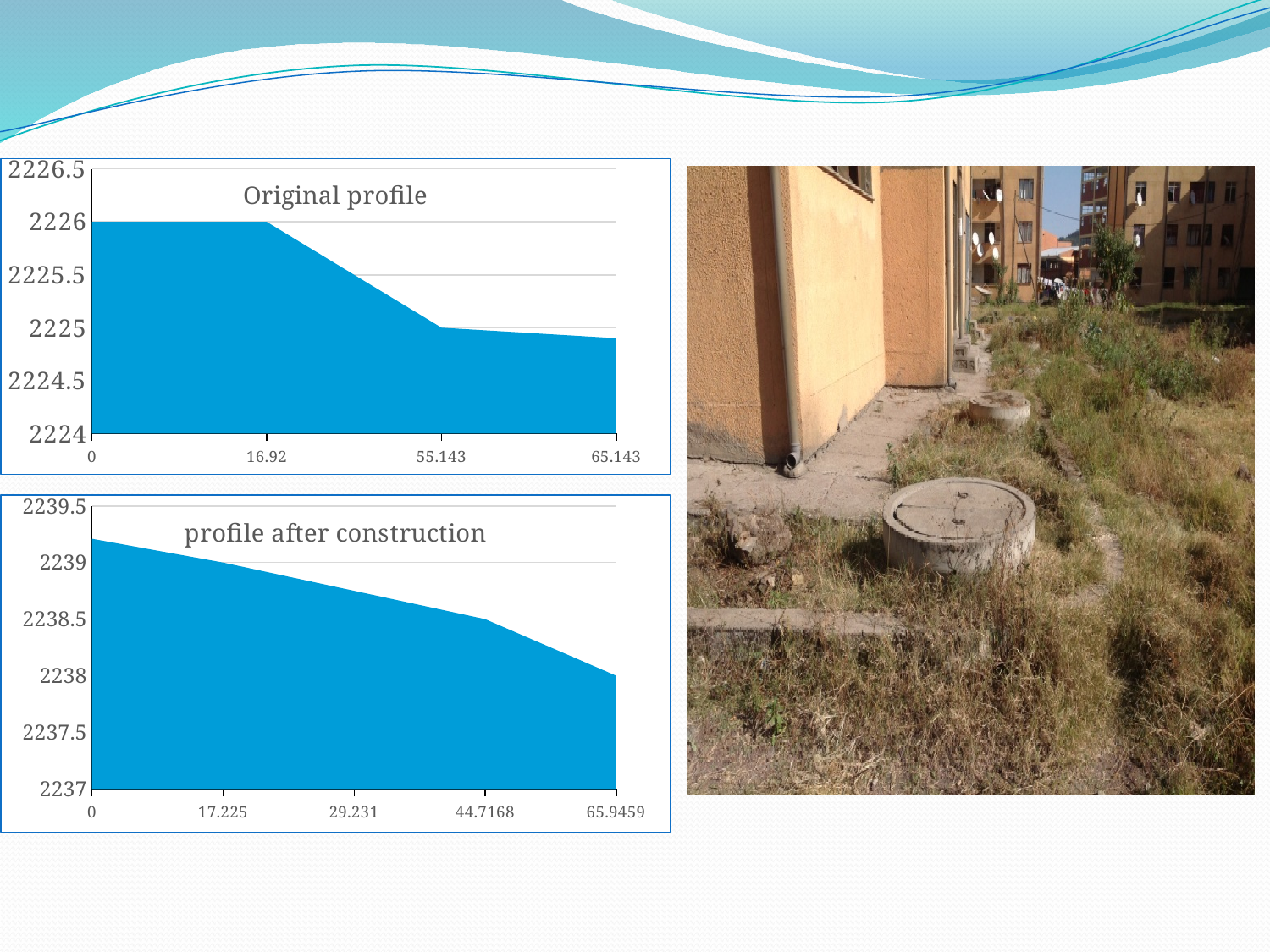
How many x-axis points are shown on the 'Original profile' chart? 4 In the 'Original profile' chart, is the value at x = 65.143 greater or less than 2225? less In the 'Original profile' chart, do the values rise or fall as x increases? fall In the 'Original profile' chart, what is the value at x = 0? 2226 In the 'profile after construction' chart, what is the value at x = 65.9459? 2238 In the 'Original profile' chart, what is the value at x = 55.143? 2225 In the 'profile after construction' chart, do the values rise or fall as x increases? fall In the 'profile after construction' chart, at which x value is the profile lowest? 65.9459 How many x-axis points are shown on the 'profile after construction' chart? 5 What kind of chart is the 'Original profile' chart? area chart What is the title of the lower chart on the slide? profile after construction In the 'profile after construction' chart, is the value at x = 0 greater or less than 2239? greater